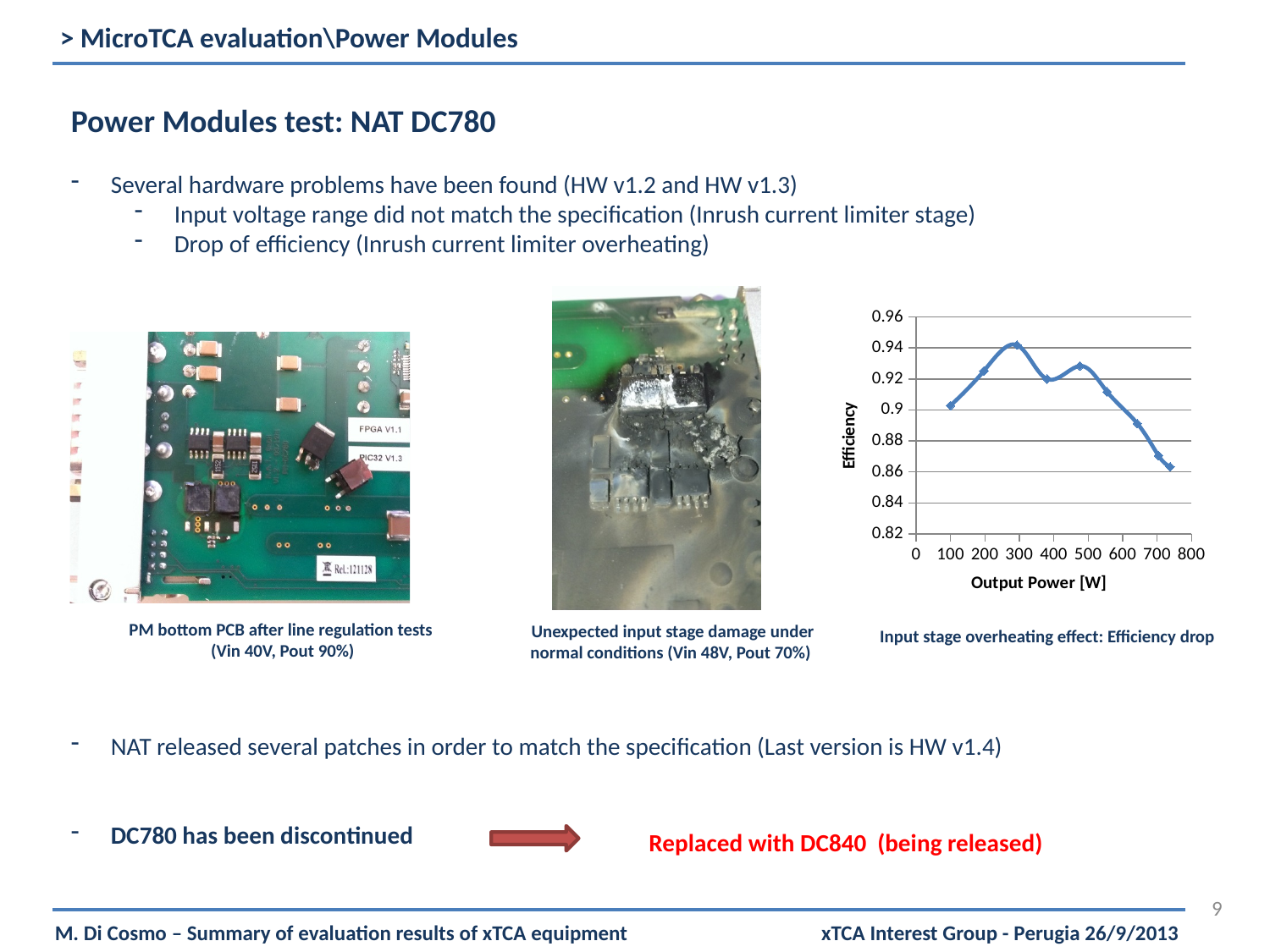
What is the label of the y axis of the chart? Efficiency Is the efficiency at 500 W output power greater or less than 0.9? greater Does the efficiency rise or fall as output power increases from 100 W to 300 W? rise Is the efficiency at 100 W output power greater or less than 0.92? less Which is higher: the efficiency at 300 W or the efficiency at 700 W? 300 W Which is higher: the efficiency at 100 W or the efficiency at 750 W? 100 W Is the efficiency at 750 W output power greater or less than 0.88? less Does the efficiency rise or fall as output power increases from 500 W to 750 W? fall What is the label of the x axis of the chart? Output Power [W] What kind of chart is shown on the slide? line chart